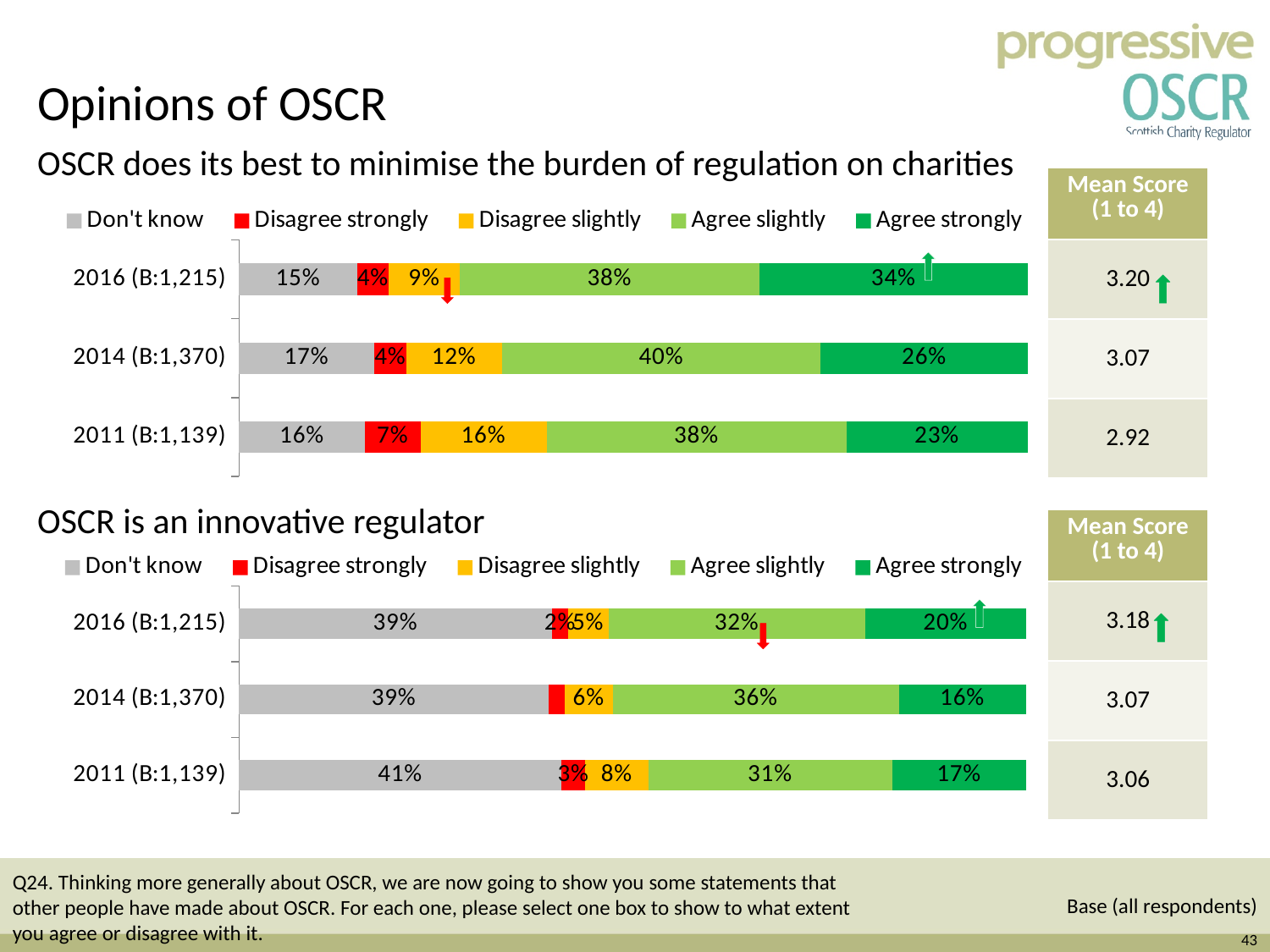
In the chart 'OSCR is an innovative regulator', what percentage of 2011 respondents answered 'Don't know'? 41% In the chart 'OSCR is an innovative regulator', what is the difference between the 'Don't know' percentages for 2011 and 2016? 2% In the chart 'OSCR does its best to minimise the burden of regulation on charities', what percentage of 2016 respondents agreed strongly? 34% In the chart 'OSCR is an innovative regulator', which year has the lowest 'Agree strongly' percentage? 2014 (B:1,370) What type of chart is used for 'OSCR does its best to minimise the burden of regulation on charities'? Stacked bar chart How many years (categories) are shown in the chart 'OSCR is an innovative regulator'? 3 In the chart 'OSCR is an innovative regulator', what percentage of 2014 respondents agreed slightly? 36% In the chart 'OSCR does its best to minimise the burden of regulation on charities', what is the difference between the 'Agree slightly' percentages for 2014 and 2011? 2% In the chart 'OSCR does its best to minimise the burden of regulation on charities', which year has the highest 'Agree strongly' percentage? 2016 (B:1,215) How many series does the legend list in the chart 'OSCR does its best to minimise the burden of regulation on charities'? 5 In the chart 'OSCR does its best to minimise the burden of regulation on charities', what percentage of 2011 respondents disagreed slightly? 16% In the chart 'OSCR is an innovative regulator', is the 'Agree strongly' percentage larger for 2016 or 2011? 2016